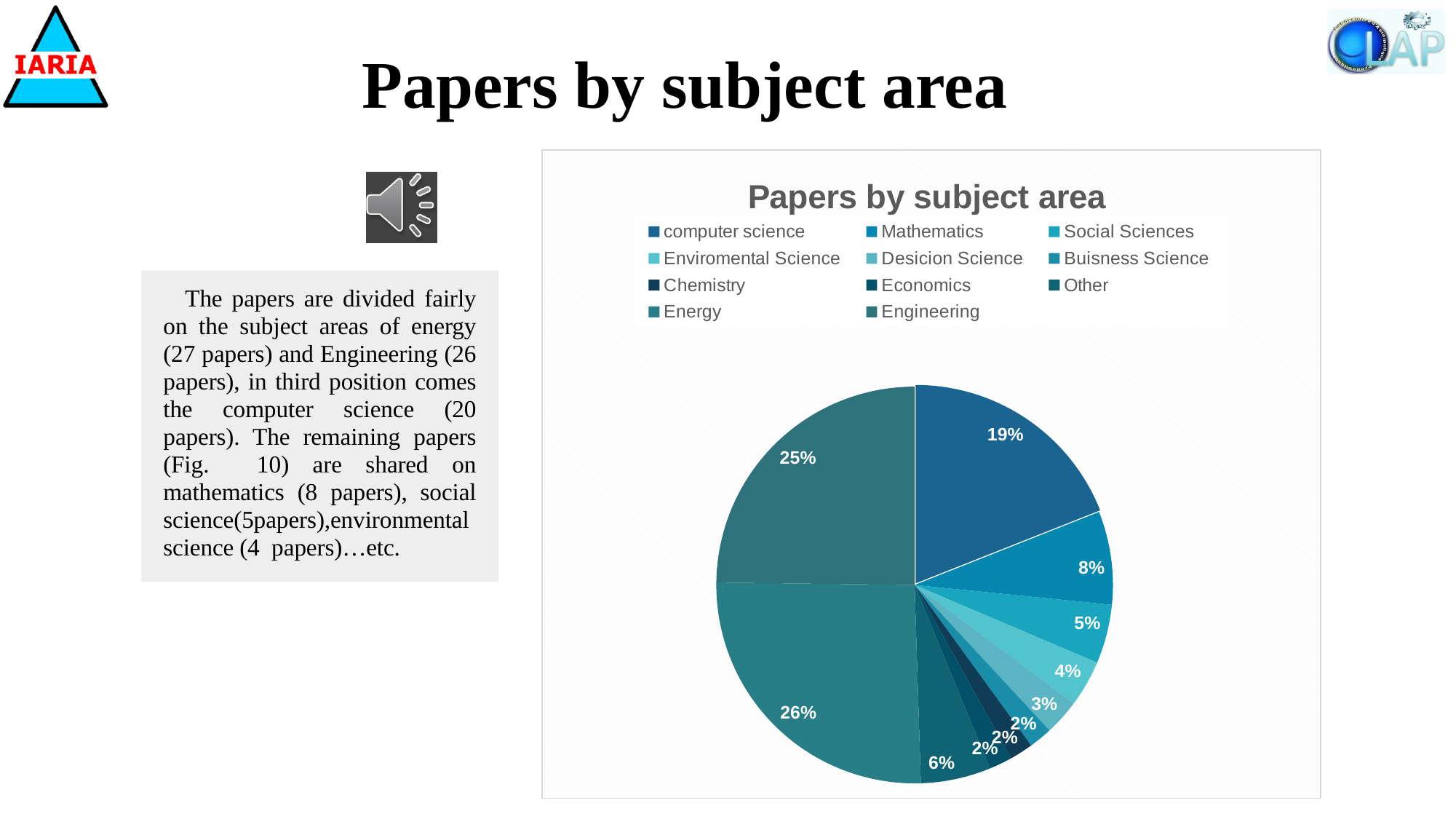
What is the value shown for Engineering? 25% How many categories does the legend of the pie chart list? 11 What type of chart is shown on the slide? pie chart Which subject area has the largest slice of the pie? Energy What share of the pie does computer science hold? 19% What is the difference between the Energy and Engineering shares? 1% What is the value shown for Other? 6% Which is larger, the share for computer science or the share for Mathematics? computer science What is the value shown for Social Sciences? 5% What is the title of the chart? Papers by subject area What is the value shown for Energy? 26% What is the value shown for Mathematics? 8%